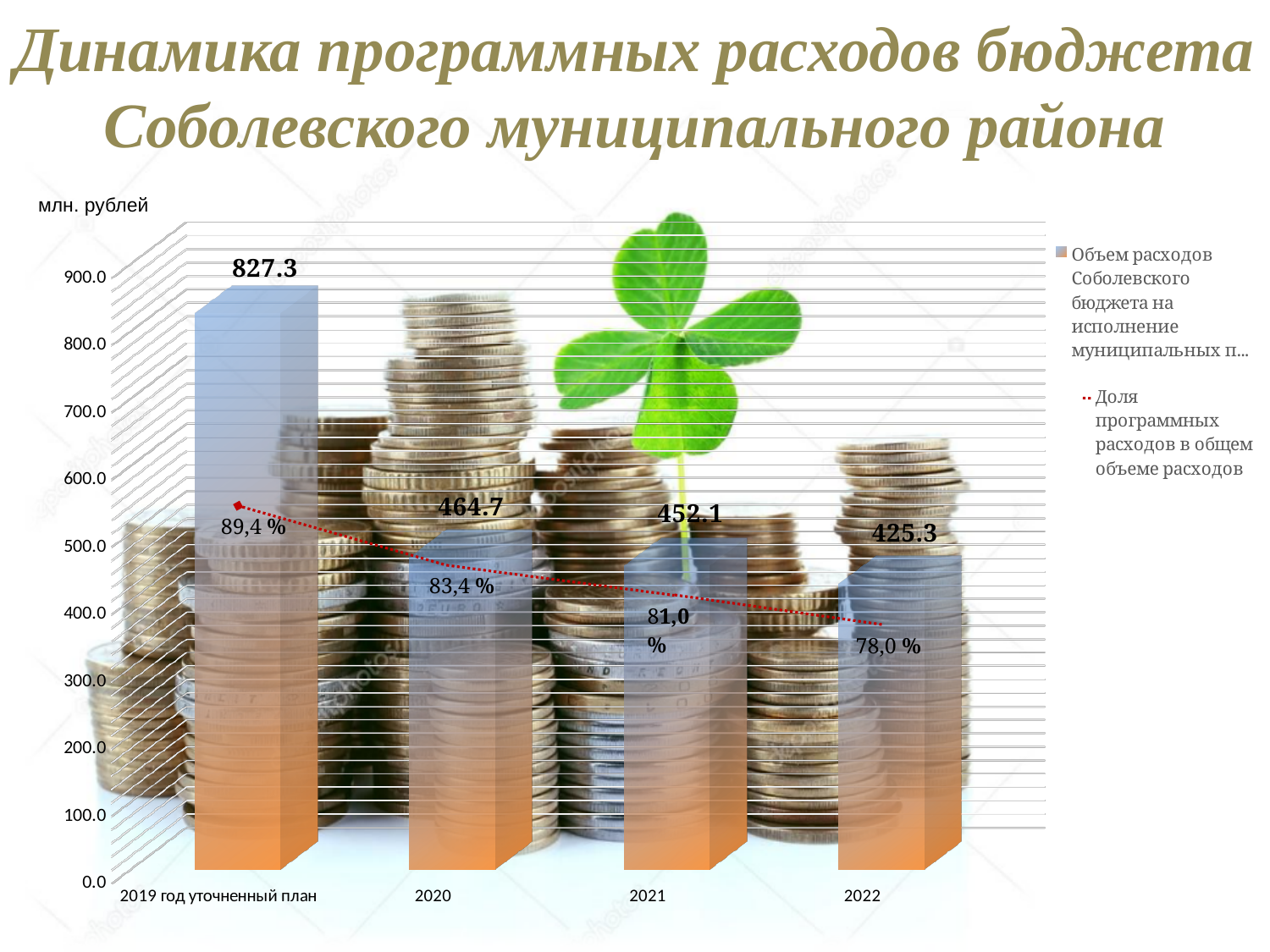
What share of programme expenditures (Доля программных расходов) is shown for 2021? 81,0 % What is the value of the bar for 2022? 425.3 Do the share values on the dotted line rise or fall from 2019 to 2022? fall What share of programme expenditures (Доля программных расходов) is shown for 2019 год уточненный план? 89,4 % Which is larger, the bar value for 2020 or for 2021? 2020 What is the value of the bar for 2020? 464.7 Which year has the highest bar value? 2019 год уточненный план What is the difference between the bar values for 2021 and 2022? 26.8 Which year has the lowest bar value? 2022 What is the value of the bar for 2019 год уточненный план? 827.3 How many series does the legend list? 2 What is the difference between the bar values for 2019 год уточненный план and 2020? 362.6